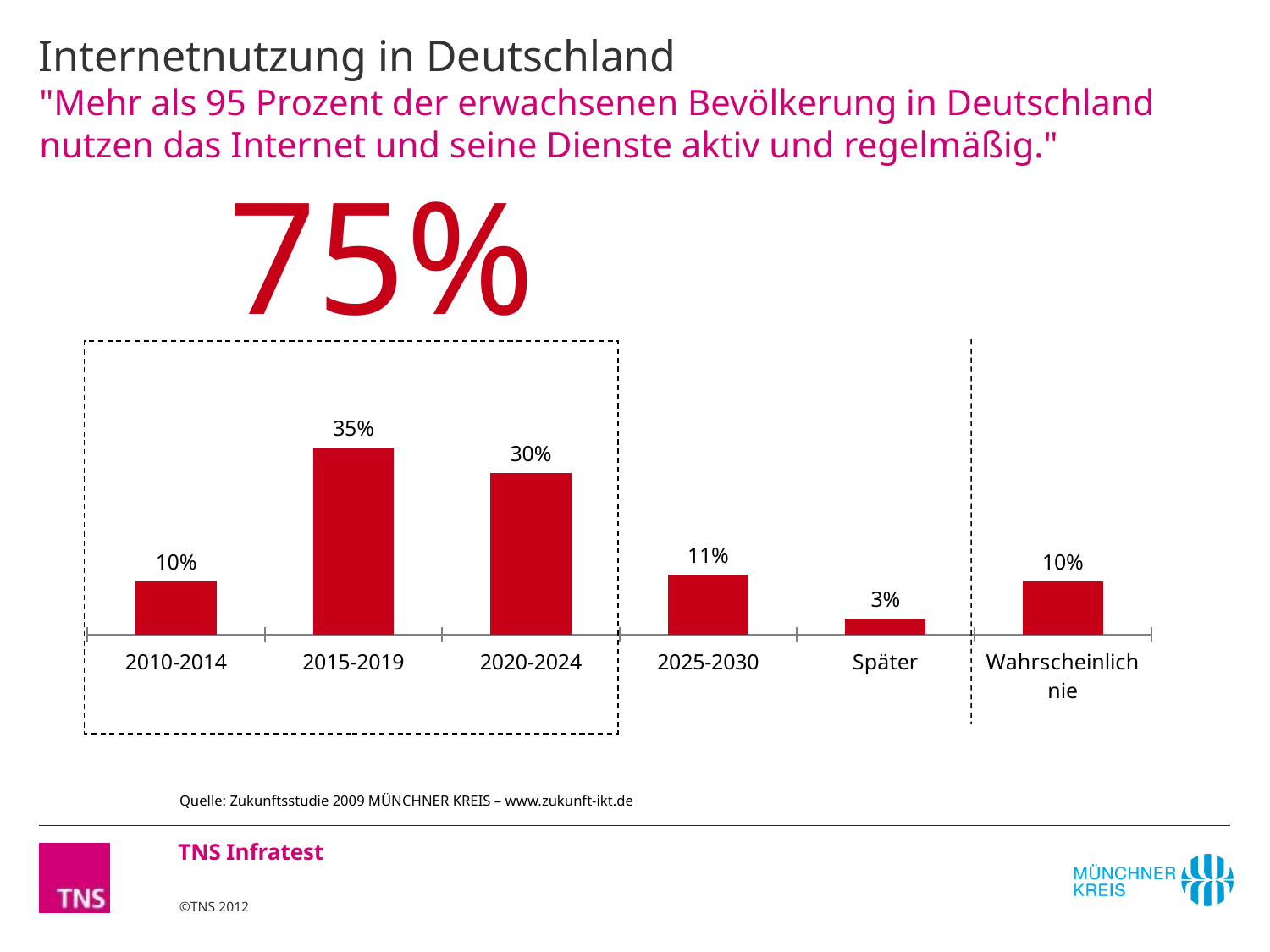
Which category has the highest value? 2015-2019 Which is larger, the value for 2025-2030 or the value for Wahrscheinlich nie? 2025-2030 What is the value for 2020-2024? 30% Which category has the lowest value? Später What is the value for 2015-2019? 35% What is the value for Später? 3% What is the difference between the values for 2015-2019 and 2020-2024? 5% What is the total of the values for 2010-2014, 2015-2019 and 2020-2024 (the categories inside the dashed box)? 75% What kind of chart is shown on the slide? bar chart How many categories are shown on the x axis? 6 What is the value for 2025-2030? 11% What large number is printed above the chart? 75%